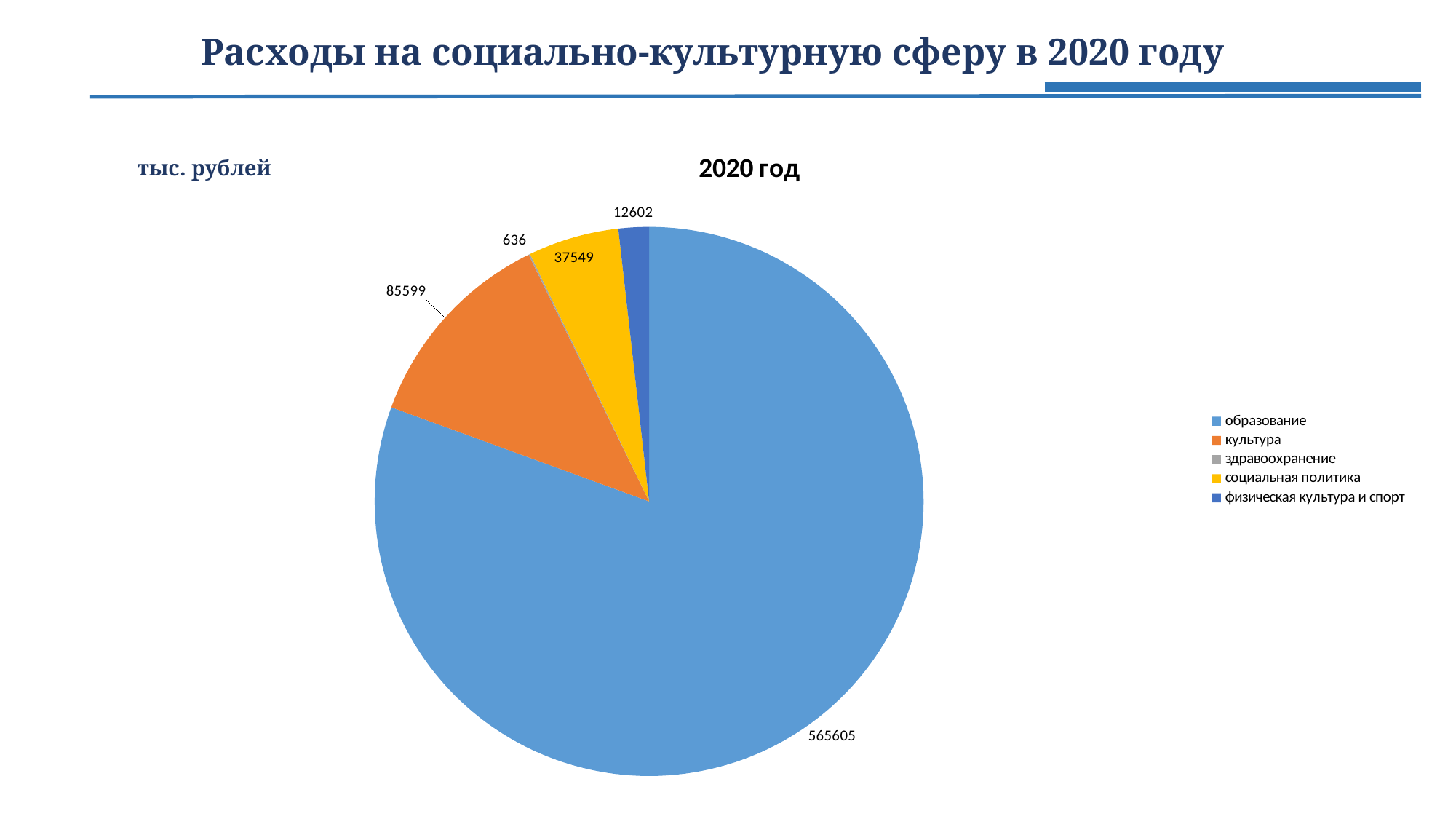
What is the value for культура in the pie chart? 85599 Which category has the smallest slice in the pie chart? здравоохранение What is the value for социальная политика in the pie chart? 37549 Which is larger: социальная политика or физическая культура и спорт? социальная политика What is the value for образование in the pie chart? 565605 What is the title shown above the pie chart? 2020 год What type of chart is shown on the slide? pie chart Which category has the largest slice in the pie chart? образование What is the difference between the values for образование and культура? 480006 What is the value for физическая культура и спорт in the pie chart? 12602 What is the value for здравоохранение in the pie chart? 636 How many categories does the legend of the pie chart list? 5